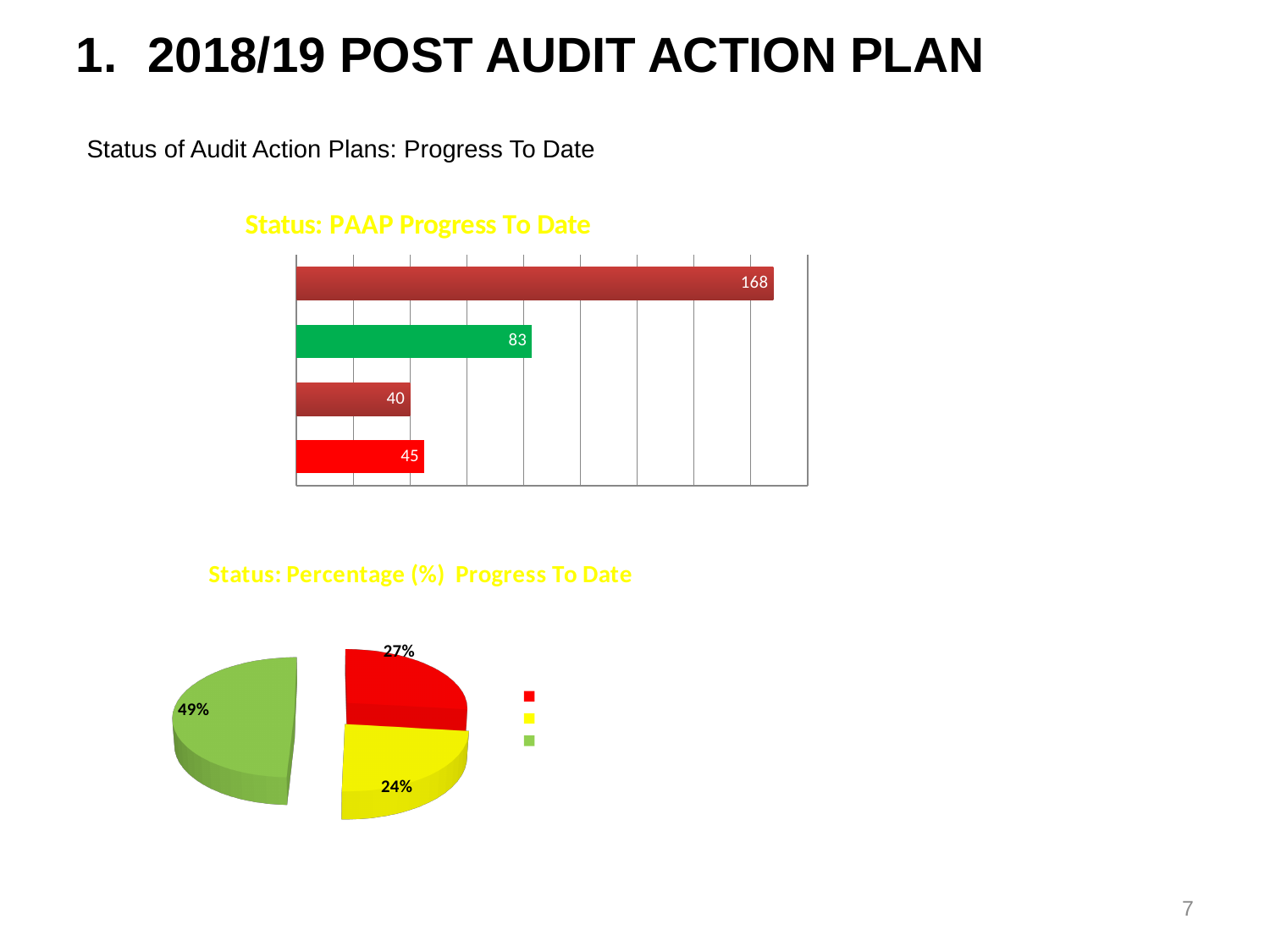
In the 'Status: PAAP Progress To Date' chart, what is the value of the top (longest) bar? 168 In the 'Status: PAAP Progress To Date' chart, which is larger: the green bar or the bottom red bar? The green bar In the 'Status: PAAP Progress To Date' chart, what is the value of the green bar? 83 In the 'Status: PAAP Progress To Date' chart, which bar has the lowest value? The third bar from the top (40) In the 'Status: PAAP Progress To Date' chart, what is the difference between the top bar and the green bar? 85 In the 'Status: PAAP Progress To Date' chart, what is the value of the bottom (bright red) bar? 45 What type of chart is 'Status: Percentage (%) Progress To Date'? Pie chart How many bars are shown in the 'Status: PAAP Progress To Date' chart? 4 In the 'Status: Percentage (%) Progress To Date' chart, what share does the green slice represent? 49% In the 'Status: Percentage (%) Progress To Date' chart, which slice is the smallest? The yellow slice (24%) What type of chart is 'Status: PAAP Progress To Date'? Bar chart In the 'Status: PAAP Progress To Date' chart, what is the difference between the bottom bar (45) and the third bar (40)? 5